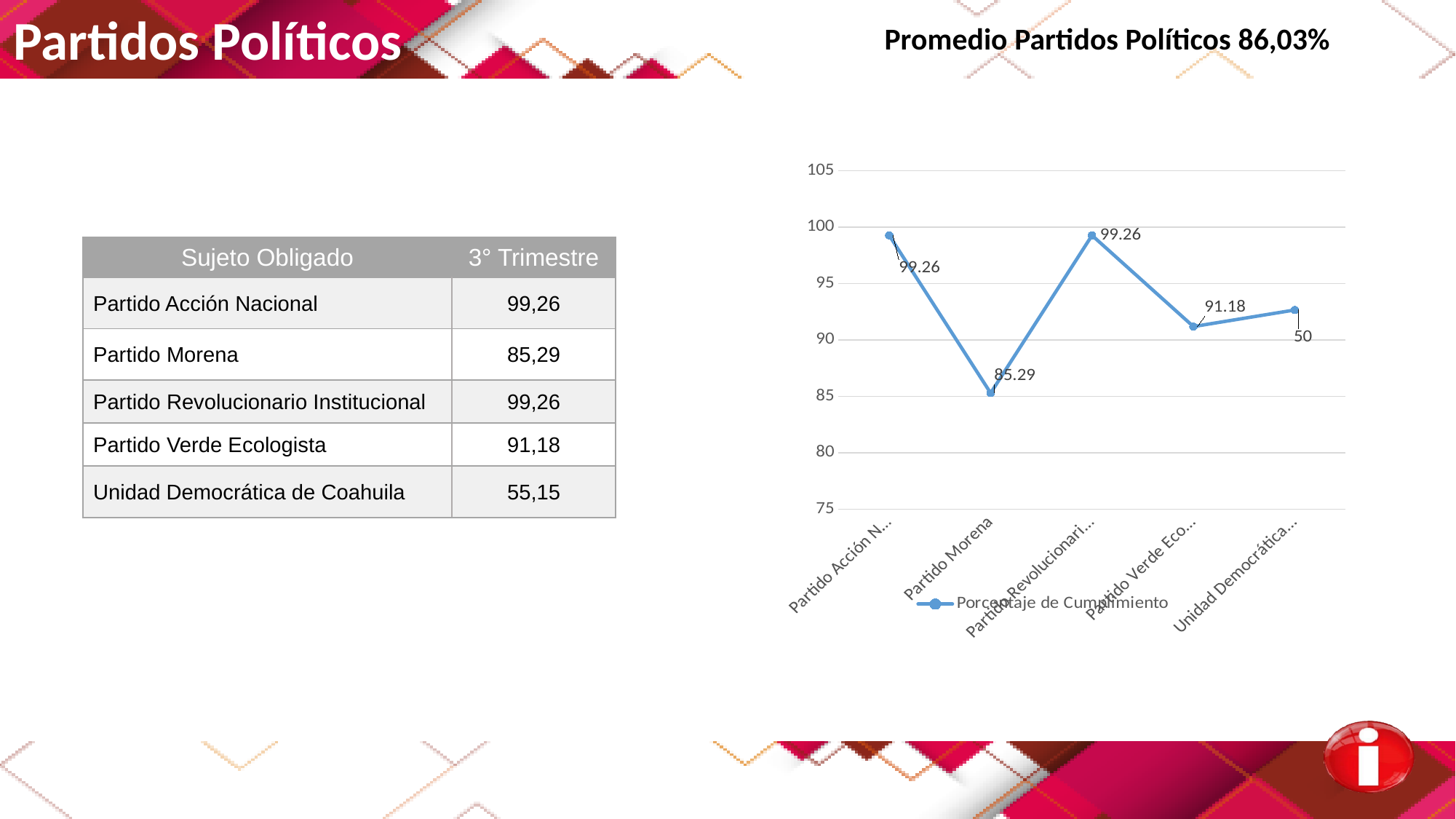
What kind of chart is shown on the slide? line chart How many data points are plotted on the line in the chart? 5 What value does the chart show for Partido Acción Nacional? 99.26 What value does the chart show for Partido Morena? 85.29 Is the value for Partido Morena greater or less than 90? less How many series does the chart legend list? 1 Which is larger, the value for Partido Verde Ecologista or the value for Partido Morena? Partido Verde Ecologista Which category has the lowest plotted value in the chart? Partido Morena Is the value for Partido Verde Ecologista greater or less than 90? greater What is the name of the series shown in the chart legend? Porcentaje de Cumplimiento What is the difference between the values for Partido Acción Nacional and Partido Verde Ecologista? 8.08 What value does the chart show for Partido Verde Ecologista? 91.18